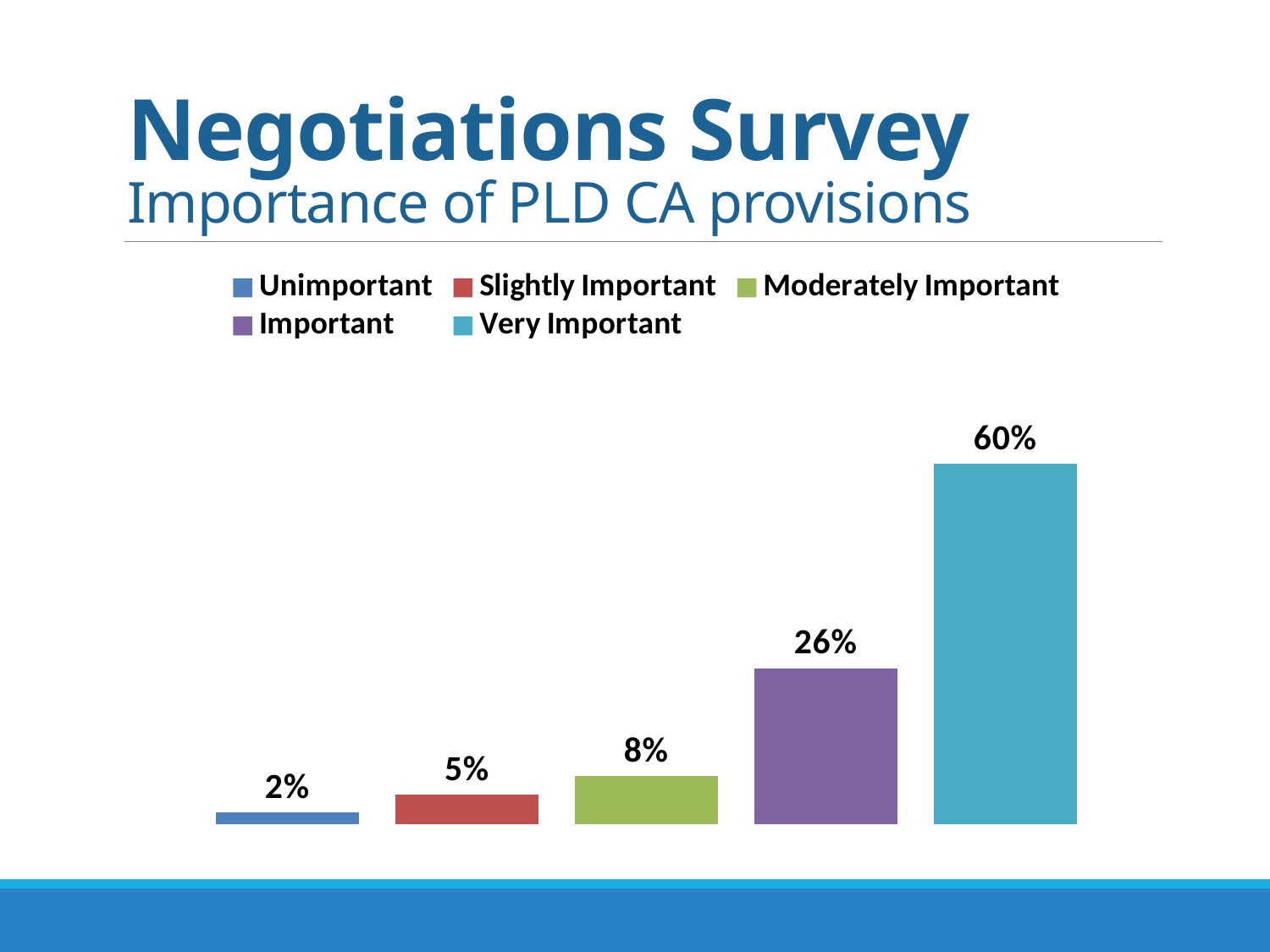
What is the difference in percentage points between Slightly Important and Unimportant? 3 Which rating category has the highest percentage? Very Important Which is larger, the percentage for Slightly Important or for Moderately Important? Moderately Important Do the values rise or fall moving from left to right across the bars? Rise Which rating category has the lowest percentage? Unimportant What percentage of respondents rated PLD CA provisions as Important? 26% What percentage of respondents rated PLD CA provisions as Very Important? 60% What percentage of respondents rated PLD CA provisions as Unimportant? 2% What percentage of respondents rated PLD CA provisions as Moderately Important? 8% How many rating categories are plotted in the chart? 5 What is the difference in percentage points between Very Important and Important? 34 What kind of chart is shown on the slide? Bar chart